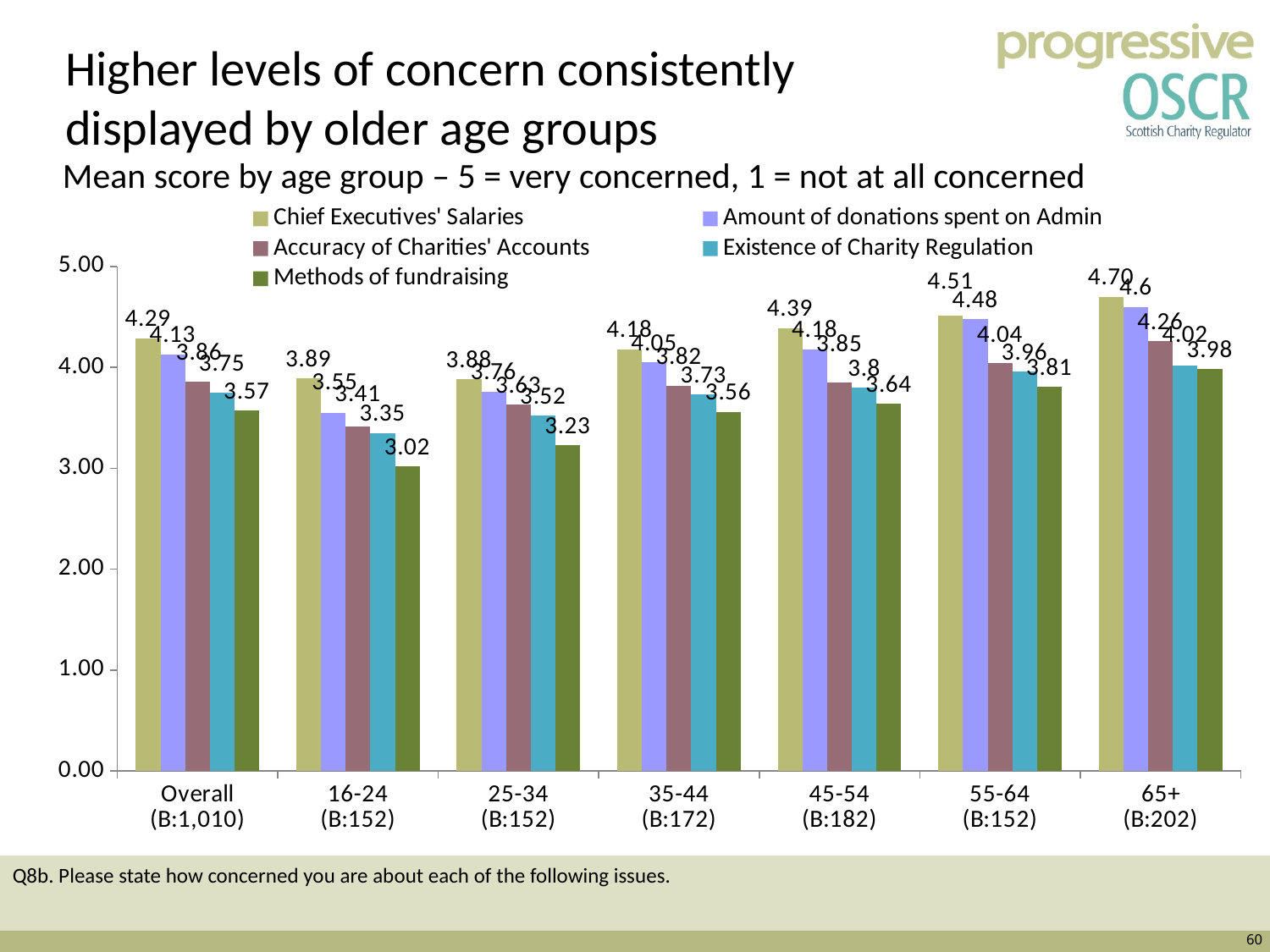
How many series does the legend list? 5 Which age group has the highest mean score for Chief Executives' Salaries? 65+ (B:202) Do the Chief Executives' Salaries scores rise or fall from the 16-24 age group to the 65+ age group? rise What is the mean score for Methods of fundraising in the 16-24 (B:152) age group? 3.02 What is the mean score for Chief Executives' Salaries in the 65+ (B:202) age group? 4.70 What kind of chart is shown on the slide? bar chart Which age group has the lowest mean score for Methods of fundraising? 16-24 (B:152) How many age group categories are shown on the x axis? 7 Is the Methods of fundraising score for 25-34 (B:152) greater or less than 3.00? greater What is the difference between the Chief Executives' Salaries score for 65+ (B:202) and for 16-24 (B:152)? 0.81 Which age group has the larger Methods of fundraising score, 35-44 (B:172) or 45-54 (B:182)? 45-54 (B:182) What is the mean score for Amount of donations spent on Admin in the 55-64 (B:152) age group? 4.48